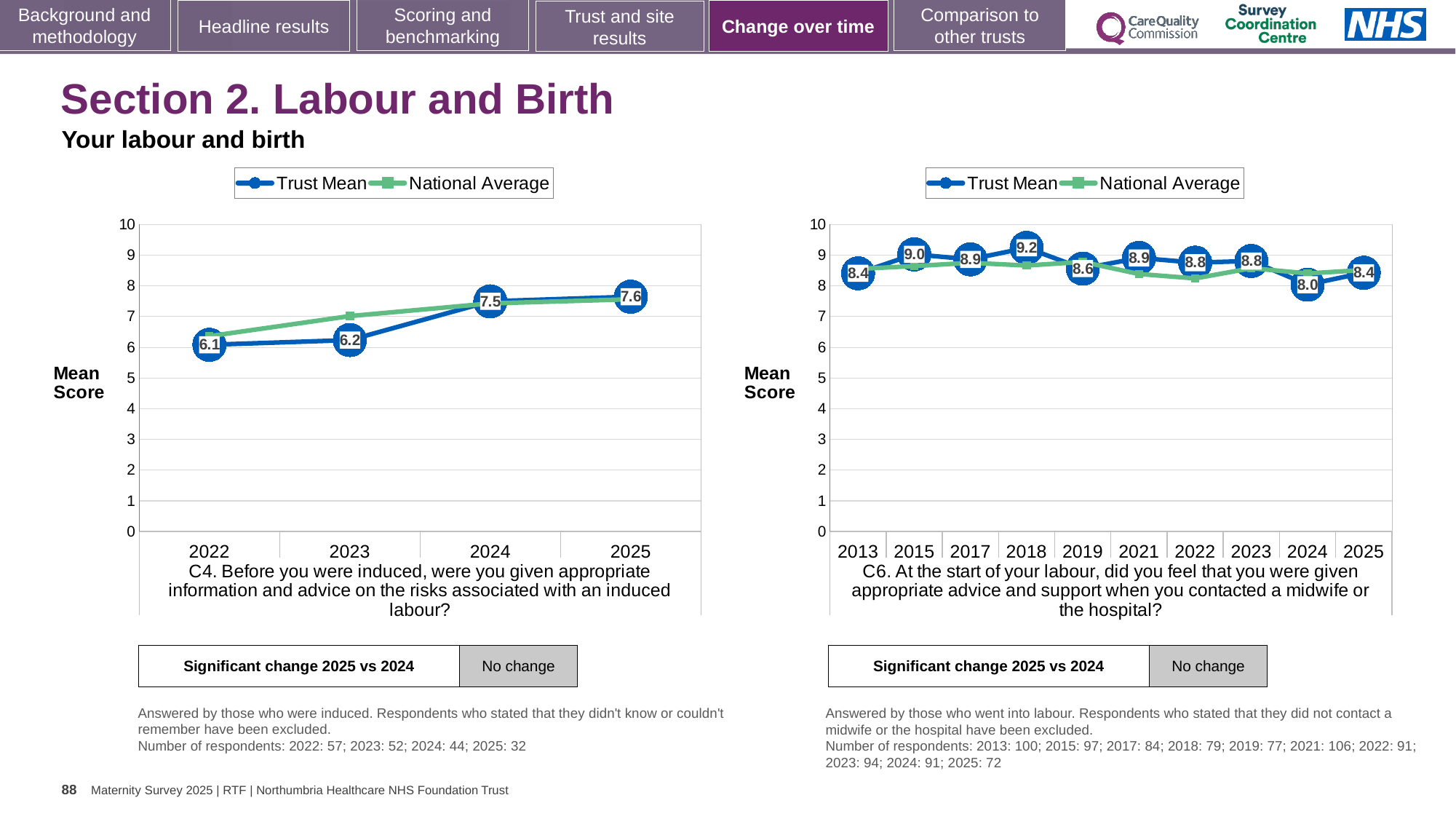
In the right chart (C6), how many years are plotted on the x axis? 10 In the left chart (C4), does the Trust Mean rise or fall from 2022 to 2025? rise How many series does the legend of the left chart (C4) list? 2 In the left chart (C4), is the National Average value for 2022 greater or less than 6? greater In the right chart (C6), what is the Trust Mean score for 2018? 9.2 In the left chart (C4), what is the difference between the Trust Mean scores for 2024 and 2023? 1.3 In the left chart (C4), what is the Trust Mean score for 2022? 6.1 In the right chart (C6), which year has the highest Trust Mean score? 2018 In the right chart (C6), which is larger, the Trust Mean for 2015 or for 2019? 2015 In the right chart (C6), which year has the lowest Trust Mean score? 2024 In the left chart (C4), what is the Trust Mean score for 2025? 7.6 In the left chart (C4), which year has the lowest Trust Mean score? 2022